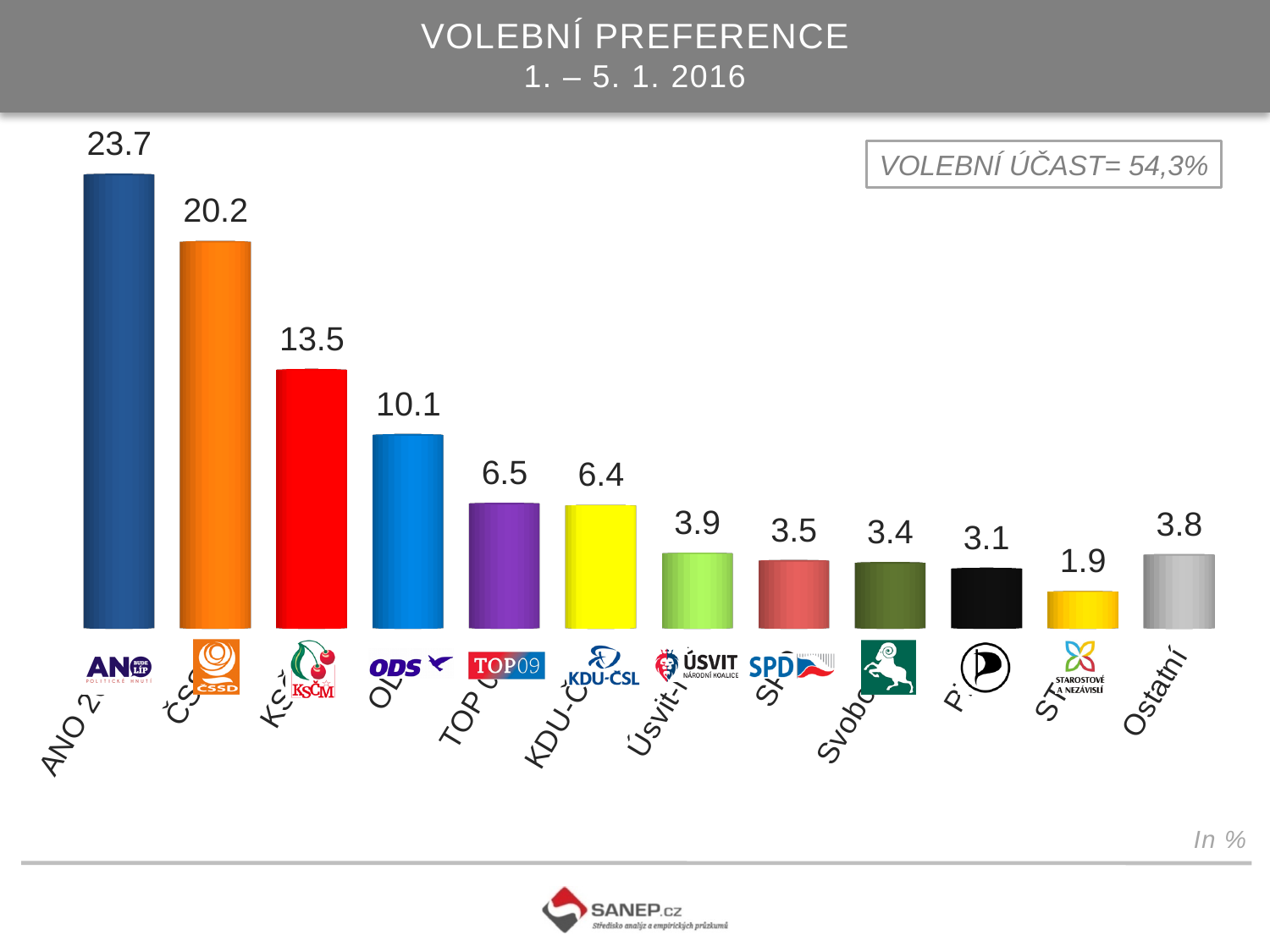
Which category has the lowest value? STAN (Starostové a nezávislí) What is the value for Ostatní? 3.8 What is the value for the ODS bar? 10.1 What kind of chart is shown on the slide? Bar chart What is the value for the KSČM bar? 13.5 What is the value for the ČSSD bar? 20.2 How many bars are shown in the chart? 12 What is the value for ANO 2011? 23.7 What voter turnout (volební účast) is stated in the box on the slide? 54,3% Which category has the highest value? ANO 2011 What is the difference between the ANO 2011 value and the ČSSD value? 3.5 Which is larger, the TOP 09 value or the KDU-ČSL value? TOP 09